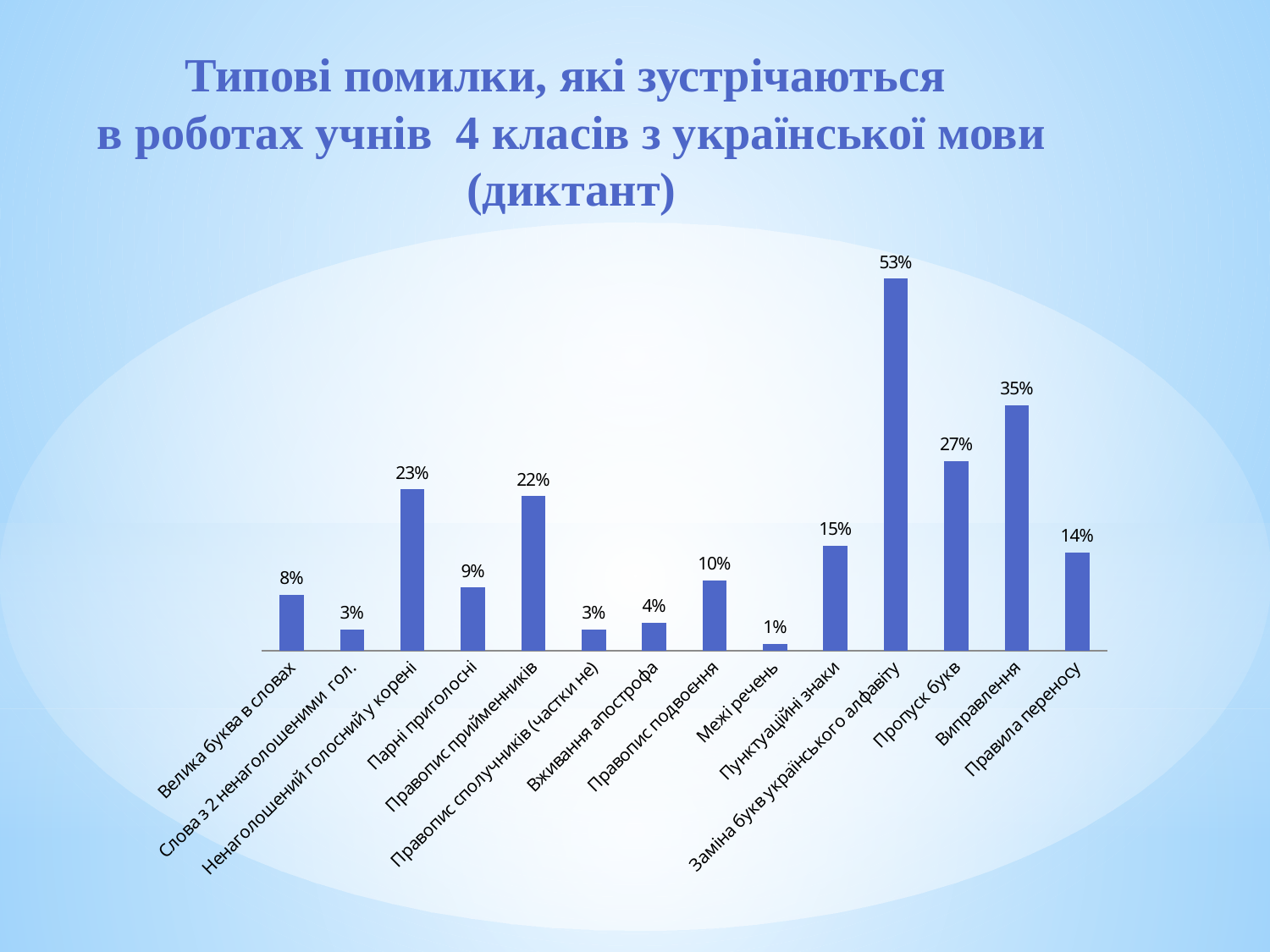
Which is larger, the value for "Ненаголошений голосний у корені" or the value for "Пунктуаційні знаки"? Ненаголошений голосний у корені What is the difference between the values for "Виправлення" and "Пропуск букв"? 8% What is the value for "Правила переносу"? 14% What is the value for "Правопис прийменників"? 22% How many categories are plotted in the chart? 14 What is the value for "Заміна букв українського алфавіту"? 53% What kind of chart is shown on the slide? bar chart What is the difference between the values for "Заміна букв українського алфавіту" and "Виправлення"? 18% Which category has the highest value? Заміна букв українського алфавіту What is the title of the slide containing the chart? Типові помилки, які зустрічаються в роботах учнів 4 класів з української мови (диктант) What is the value for "Вживання апострофа"? 4% Which category has the lowest value? Межі речень